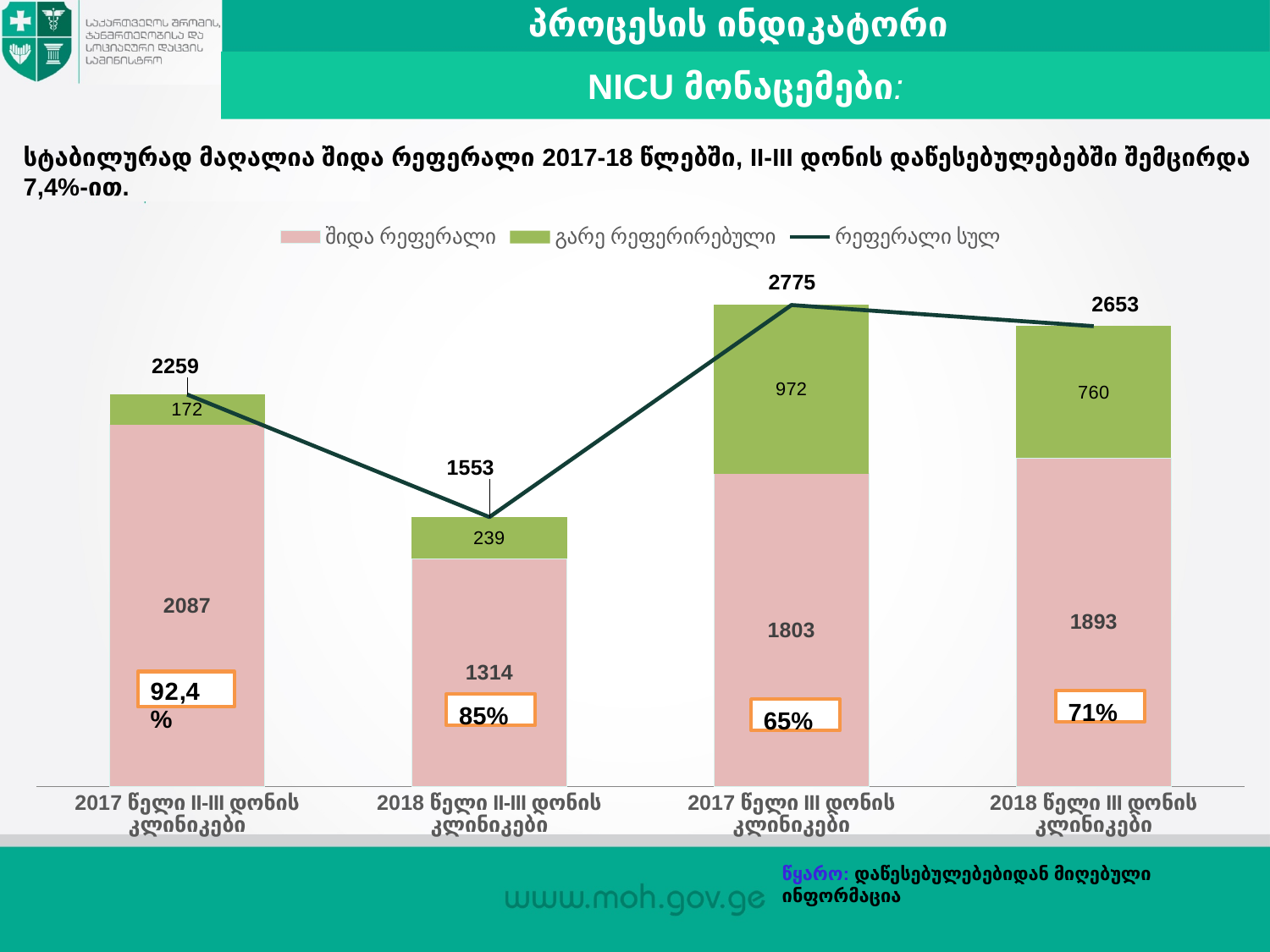
Which is larger: შიდა რეფერალი for 2017 წელი III დონის კლინიკები or for 2018 წელი III დონის კლინიკები? 2018 წელი III დონის კლინიკები What is the value of გარე რეფერირებული for 2018 წელი III დონის კლინიკები? 760 How many series does the legend list? 3 What is the value of გარე რეფერირებული for 2018 წელი II-III დონის კლინიკები? 239 What is the value of რეფერალი სულ for 2017 წელი III დონის კლინიკები? 2775 What type of chart is shown on the slide? Stacked bar chart with a line How many categories are shown on the x axis? 4 Which category has the lowest რეფერალი სულ value? 2018 წელი II-III დონის კლინიკები What percentage label is shown on the bar for 2018 წელი II-III დონის კლინიკები? 85% What is the difference between the რეფერალი სულ values for 2017 წელი III დონის კლინიკები and 2018 წელი III დონის კლინიკები? 122 What is the value of შიდა რეფერალი for 2017 წელი II-III დონის კლინიკები? 2087 Which category has the highest რეფერალი სულ value? 2017 წელი III დონის კლინიკები